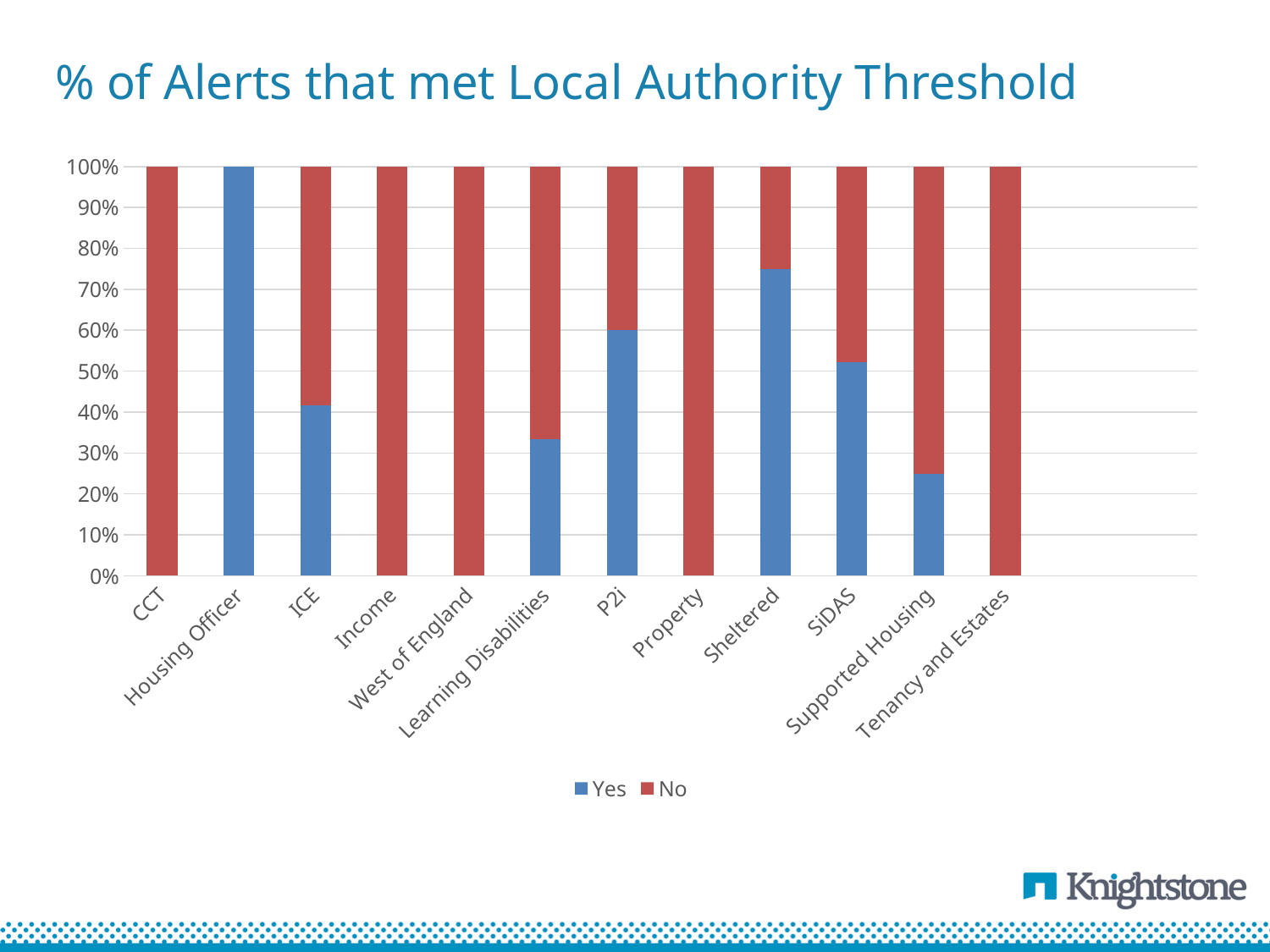
Which colour represents the No series in the legend? Red Is the Yes value for Sheltered greater or less than 70%? greater Which category has the highest Yes share? Housing Officer How many series does the legend list? 2 What is the Yes value for Housing Officer? 100% What is the Yes value for P2i? 60% Which has the larger Yes share, Sheltered or SiDAS? Sheltered How many categories are shown on the x axis? 12 What is the No value for CCT? 100% Is the Yes value for Supported Housing greater or less than 30%? less What kind of chart is shown on the slide? Stacked bar chart What is the title of the chart? % of Alerts that met Local Authority Threshold